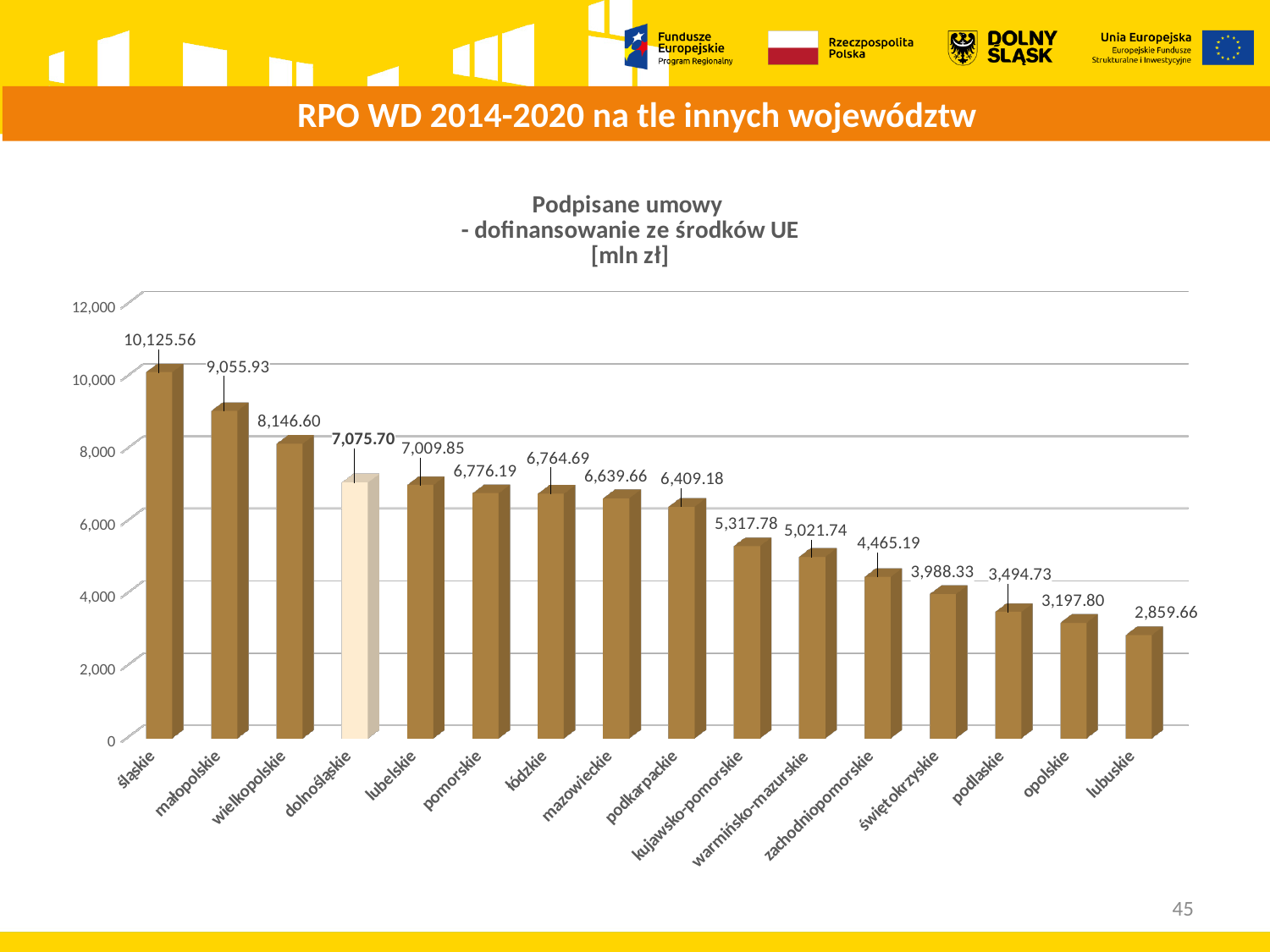
Which voivodeship has the lowest value? lubuskie Which voivodeship has the highest value? śląskie What is the value for mazowieckie? 6,639.66 How many voivodeships are shown on the x axis? 16 What is the difference between the values for dolnośląskie and lubelskie? 65.85 What kind of chart is shown on the slide? bar chart Is the value for podlaskie greater or less than 4,000? less What is the value for świętokrzyskie? 3,988.33 Which is larger, the value for małopolskie or the value for wielkopolskie? małopolskie What is the value for dolnośląskie? 7,075.70 What is the difference between the values for śląskie and lubuskie? 7,265.90 Do the values rise or fall from left to right along the x axis? fall